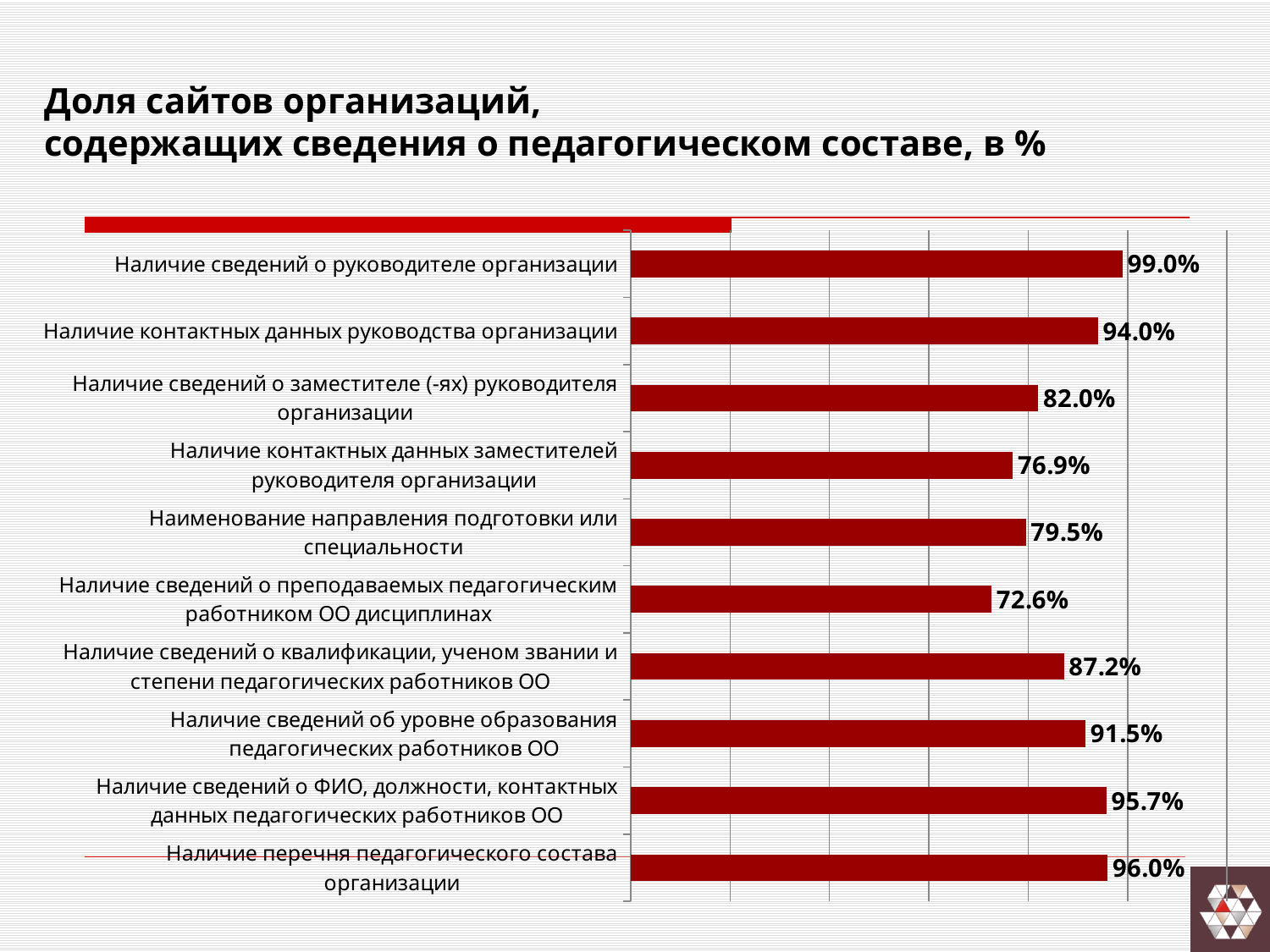
Which category has the highest value? Наличие сведений о руководителе организации What is the value for «Наличие сведений о преподаваемых педагогическим работником ОО дисциплинах»? 72.6% What is the difference between «Наличие контактных данных руководства организации» and «Наличие сведений о заместителе (-ях) руководителя организации»? 12.0 percentage points What is the value for «Наличие сведений об уровне образования педагогических работников ОО»? 91.5% Which is larger: the value for «Наименование направления подготовки или специальности» or for «Наличие контактных данных заместителей руководителя организации»? Наименование направления подготовки или специальности Which category has the lowest value? Наличие сведений о преподаваемых педагогическим работником ОО дисциплинах What is the value for «Наличие перечня педагогического состава организации»? 96.0% What is the title of the slide? Доля сайтов организаций, содержащих сведения о педагогическом составе, в % How many categories are shown in the chart? 10 What kind of chart is shown on the slide? Bar chart What is the difference between the highest value (99.0%) and the lowest value (72.6%)? 26.4 percentage points What is the value for «Наличие сведений о руководителе организации»? 99.0%